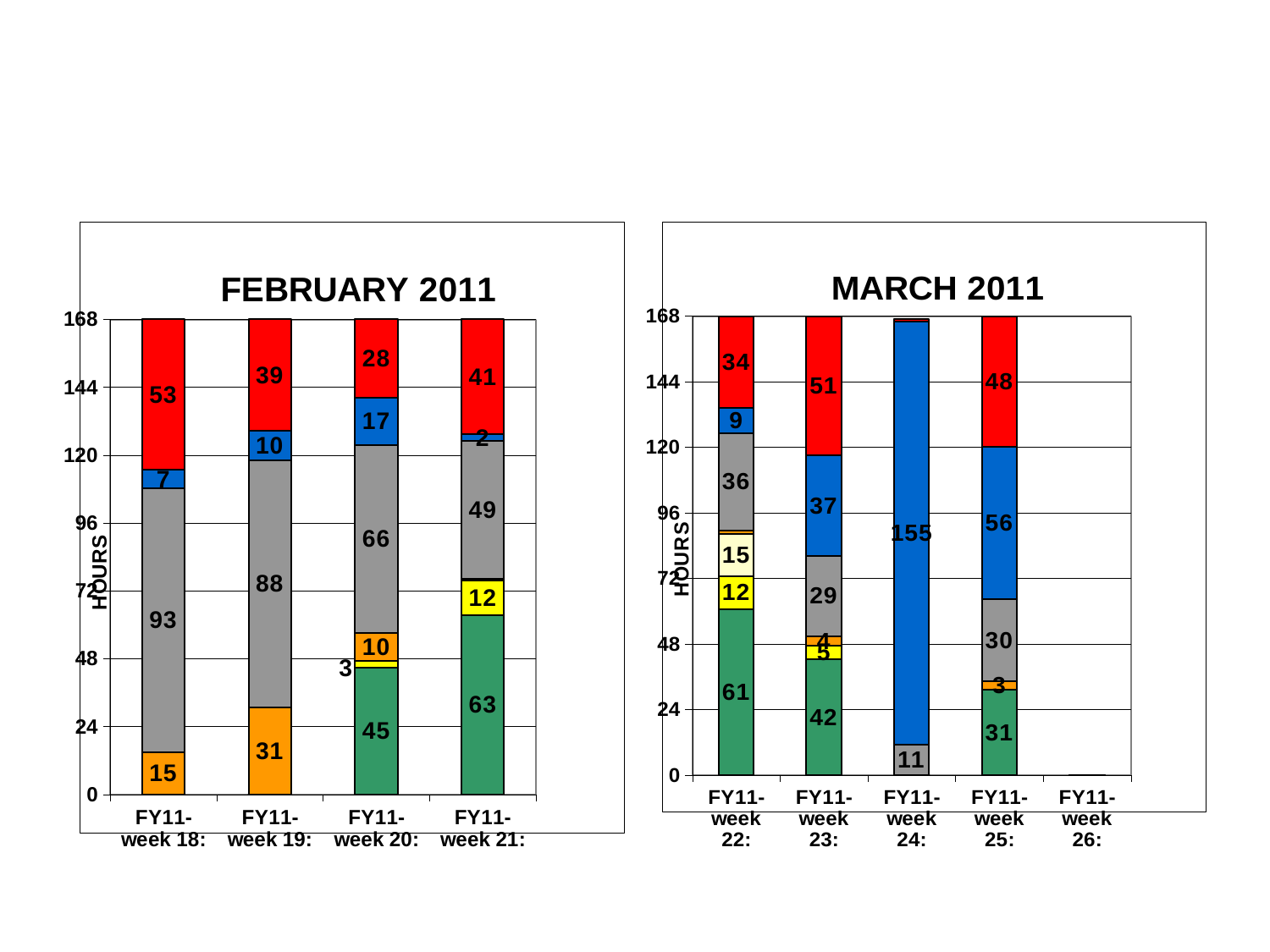
In the FEBRUARY 2011 chart, what is the value of the gray segment for FY11-week 18? 93 In the FEBRUARY 2011 chart, what is the value of the orange segment for FY11-week 19? 31 In the FEBRUARY 2011 chart, what is the difference between the green segments of FY11-week 21 and FY11-week 20? 18 In the MARCH 2011 chart, what is the value of the green segment for FY11-week 22? 61 In the MARCH 2011 chart, which is larger: the blue segment for FY11-week 25 or the blue segment for FY11-week 23? FY11-week 25 How many weeks are shown on the x axis of the MARCH 2011 chart? 5 In the FEBRUARY 2011 chart, what is the total of the stacked bar for FY11-week 19? 168 In the FEBRUARY 2011 chart, which week has the largest red segment? FY11-week 18 In the MARCH 2011 chart, what is the value of the blue segment for FY11-week 24? 155 What kind of chart is the FEBRUARY 2011 chart? Stacked bar chart What is the label on the vertical axis of the MARCH 2011 chart? HOURS